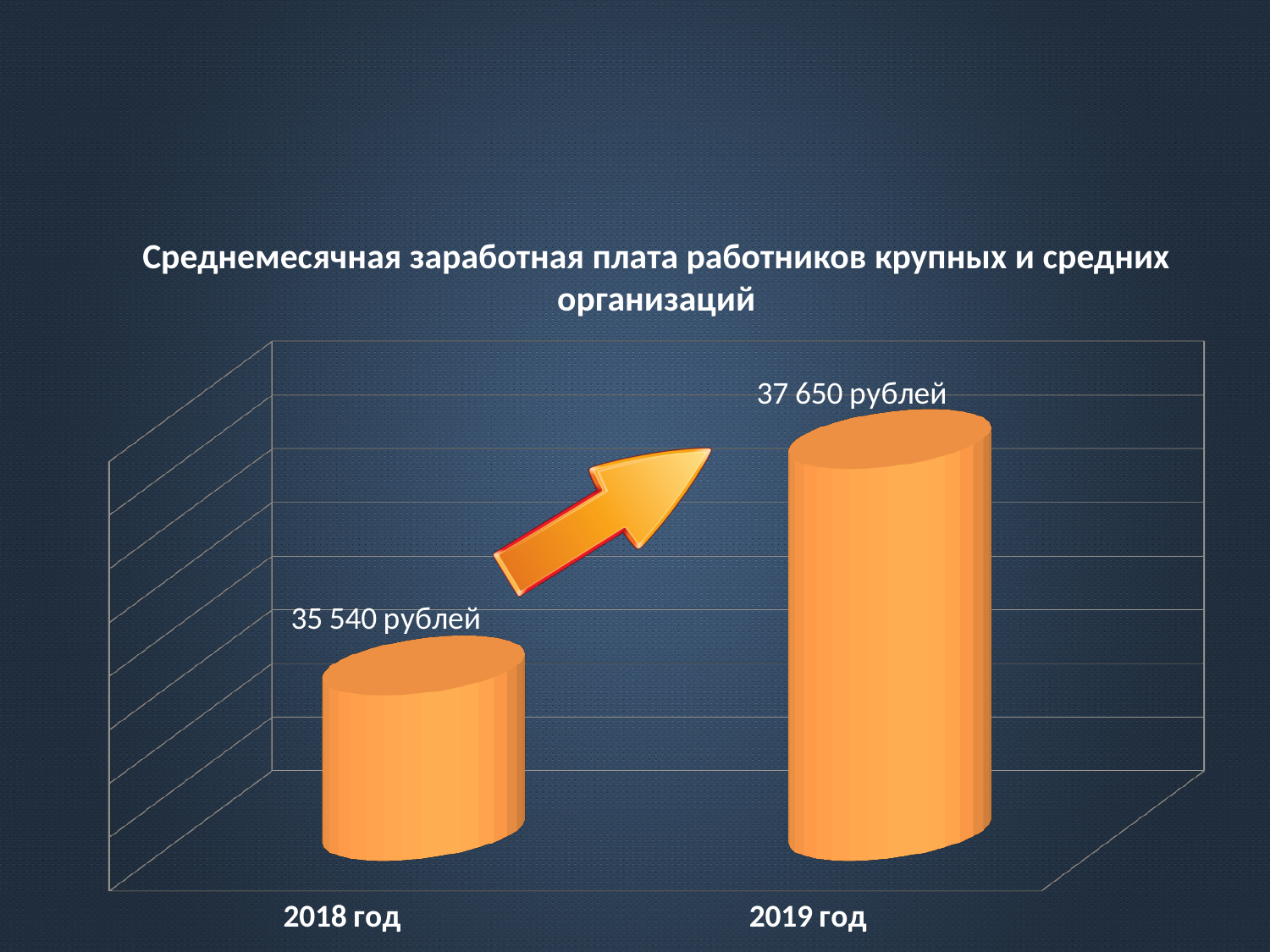
What is the difference between the values for 2019 год and 2018 год? 2 110 рублей What kind of chart is shown on the slide? bar chart What is the value for 2018 год? 35 540 рублей How many categories are shown on the chart? 2 What is the value for 2019 год? 37 650 рублей Which is larger, the value for 2018 год or the value for 2019 год? 2019 год Do the values rise or fall from 2018 год to 2019 год? rise What colour are the bars on the chart? orange What is the title of the chart? Среднемесячная заработная плата работников крупных и средних организаций Which year has the highest value? 2019 год Which year has the lowest value? 2018 год